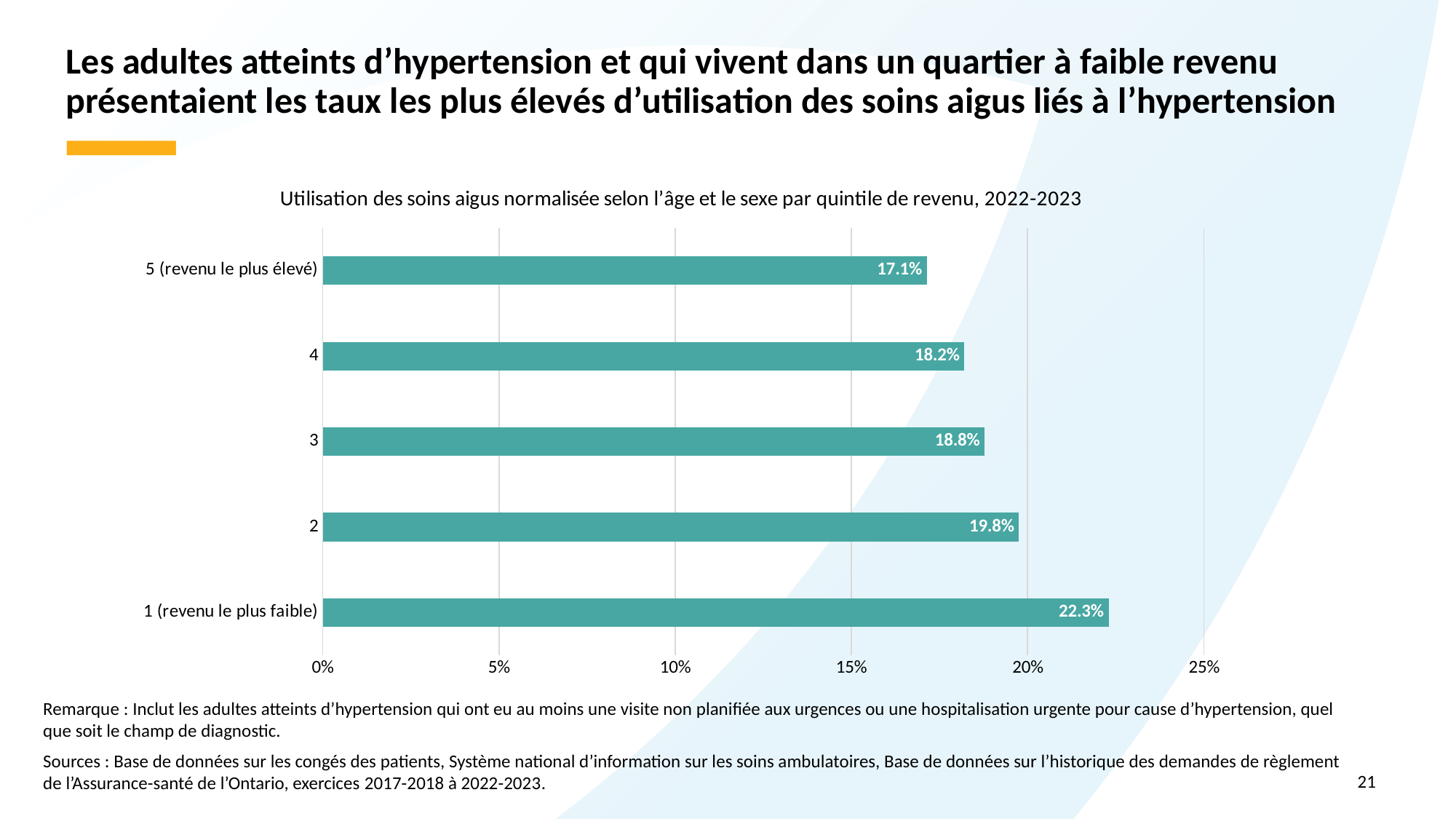
What is the difference between the values for quintile 2 and quintile 4? 1.6% Which is larger, the value for quintile 2 or the value for quintile 3? quintile 2 What is the difference between the values for quintile 1 and quintile 5? 5.2% Which income quintile has the lowest acute care use? 5 (revenu le plus élevé) Is the value for quintile 4 greater or less than 20%? less What kind of chart is shown on the slide? bar chart Which income quintile has the highest acute care use? 1 (revenu le plus faible) How many income quintiles are shown in the chart? 5 What is the value for quintile 5 (revenu le plus élevé)? 17.1% What is the value for quintile 3? 18.8% What is the title of the chart? Utilisation des soins aigus normalisée selon l'âge et le sexe par quintile de revenu, 2022-2023 What is the value for quintile 1 (revenu le plus faible)? 22.3%